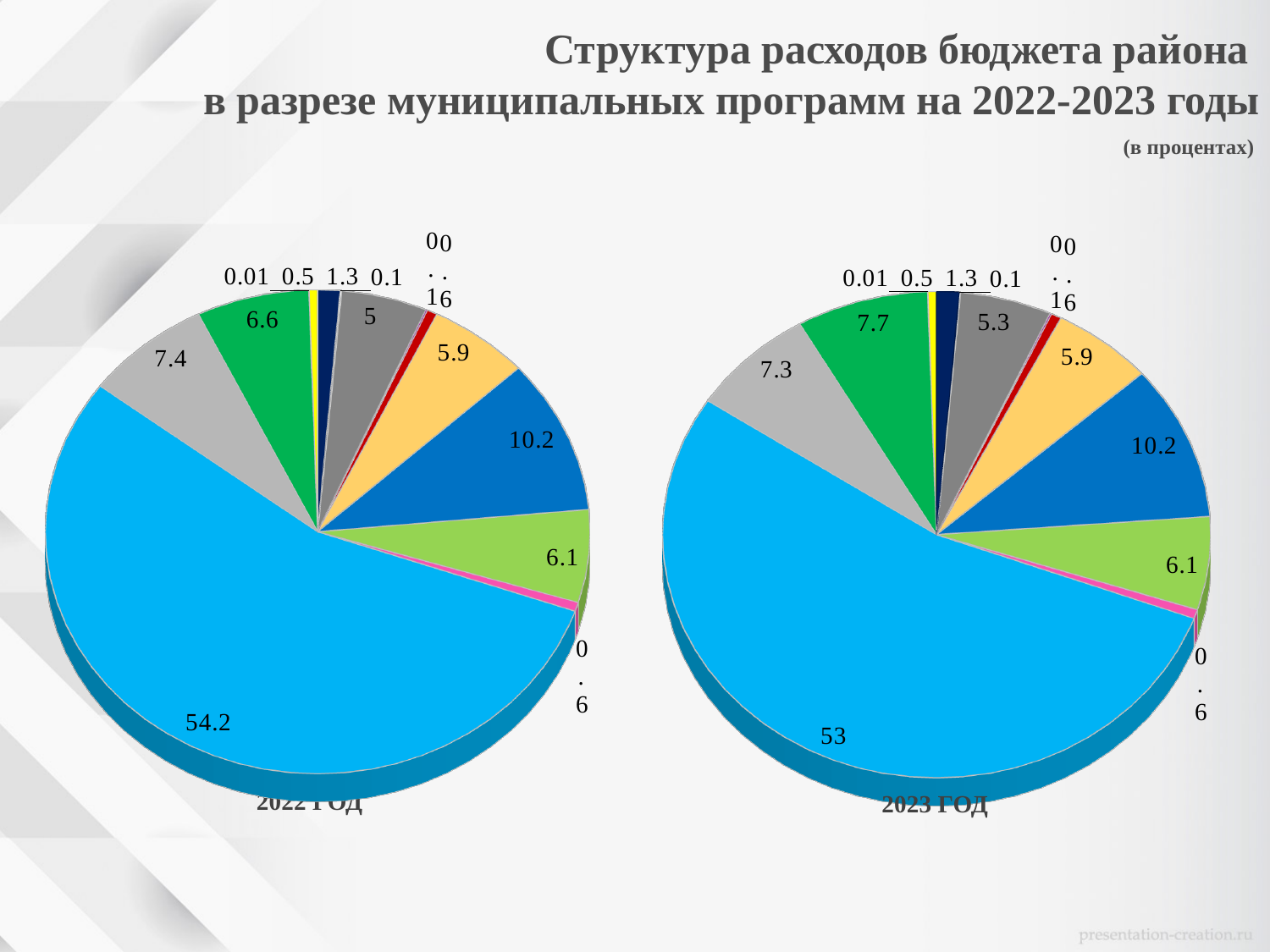
In the 2022 ГОД chart, what is the value of the green slice? 6.6 What is the difference between the green slice in the 2023 ГОД chart and the green slice in the 2022 ГОД chart? 1.1 In the 2023 ГОД chart, what is the value of the dark blue slice? 10.2 In the 2023 ГОД chart, what is the value of the largest slice? 53 Which chart has the larger biggest slice, 2022 ГОД or 2023 ГОД? 2022 ГОД In the 2023 ГОД chart, what is the value of the dark grey slice? 5.3 In what units are the values on the slide expressed, according to the subtitle? в процентах In the 2022 ГОД chart, is the largest slice greater or less than 50? greater What is the difference between the largest slice in the 2022 ГОД chart and the largest slice in the 2023 ГОД chart? 1.2 In the 2023 ГОД chart, what is the value of the green slice? 7.7 What kind of chart is used for the 2022 ГОД data? pie chart In the 2022 ГОД chart, what is the value of the largest slice? 54.2